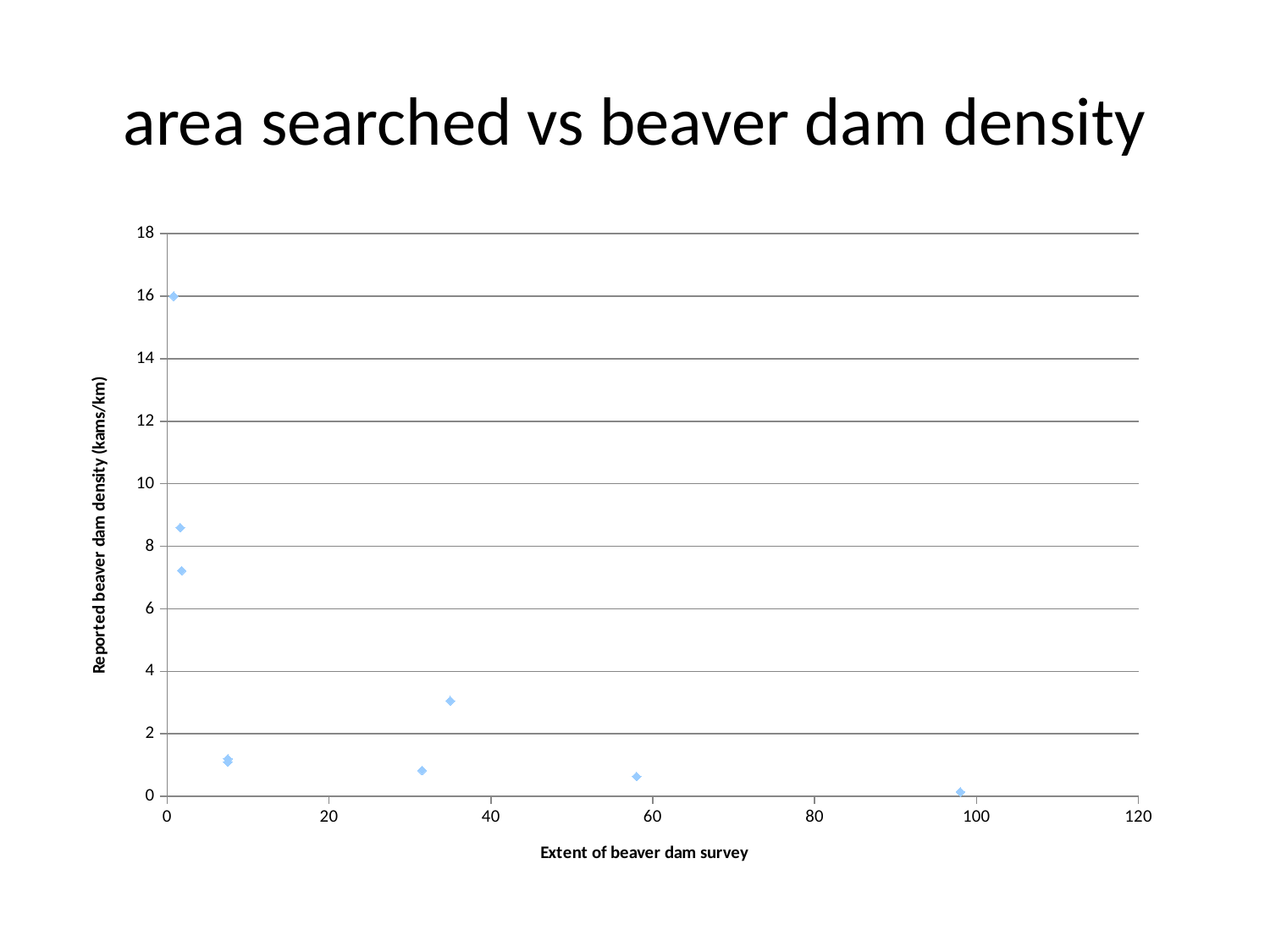
What is the title of the chart? area searched vs beaver dam density Is the reported beaver dam density for the point near an extent of 31 greater or less than 2? less What is the label of the x axis? Extent of beaver dam survey Which has the higher reported beaver dam density: the point near an extent of 35 or the point near an extent of 58? the point near 35 What is the maximum value shown on the y axis? 18 What kind of chart is shown on the slide? scatter chart Is the highest plotted beaver dam density greater or less than 14? greater Do the reported beaver dam density values generally rise or fall as the extent of the survey increases? fall Is the reported beaver dam density for the point near an extent of 35 greater or less than 2? greater